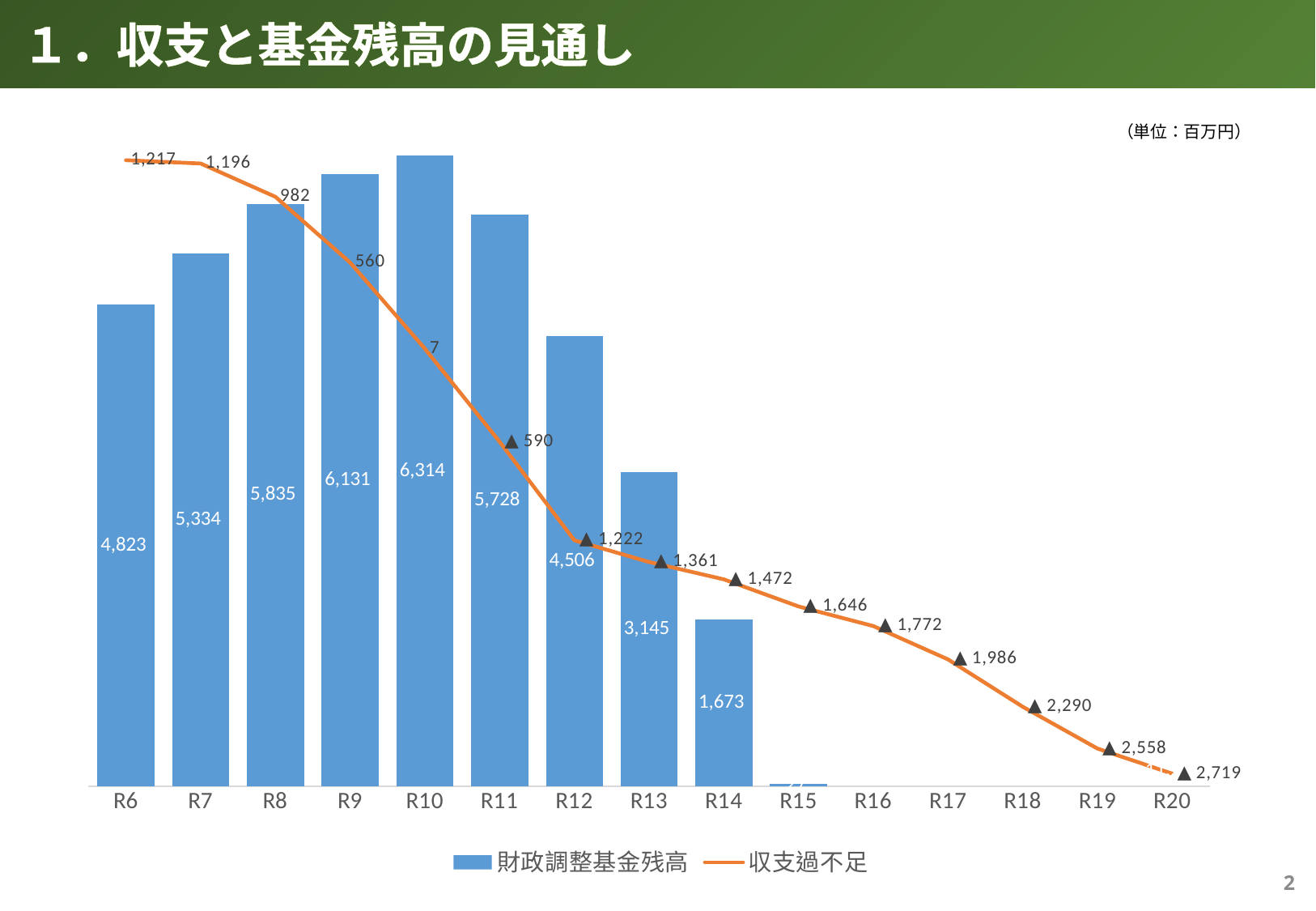
Which year has the highest 収支過不足 value on the line? R6 What is the value of 財政調整基金残高 for R10? 6,314 Which is larger, the 財政調整基金残高 for R8 or for R11? R8 What is the difference between the 収支過不足 values for R6 and R7? 21 What kind of chart is shown on the slide? Combined bar and line chart How many series does the legend list? 2 What is the value of 収支過不足 for R20? ▲2,719 How many years are shown on the x axis? 15 What is the difference between the 財政調整基金残高 values for R10 and R9? 183 Does the 収支過不足 line rise or fall from R6 to R20? Fall Which year has the highest 財政調整基金残高 bar? R10 What is the value of 収支過不足 for R9? 560